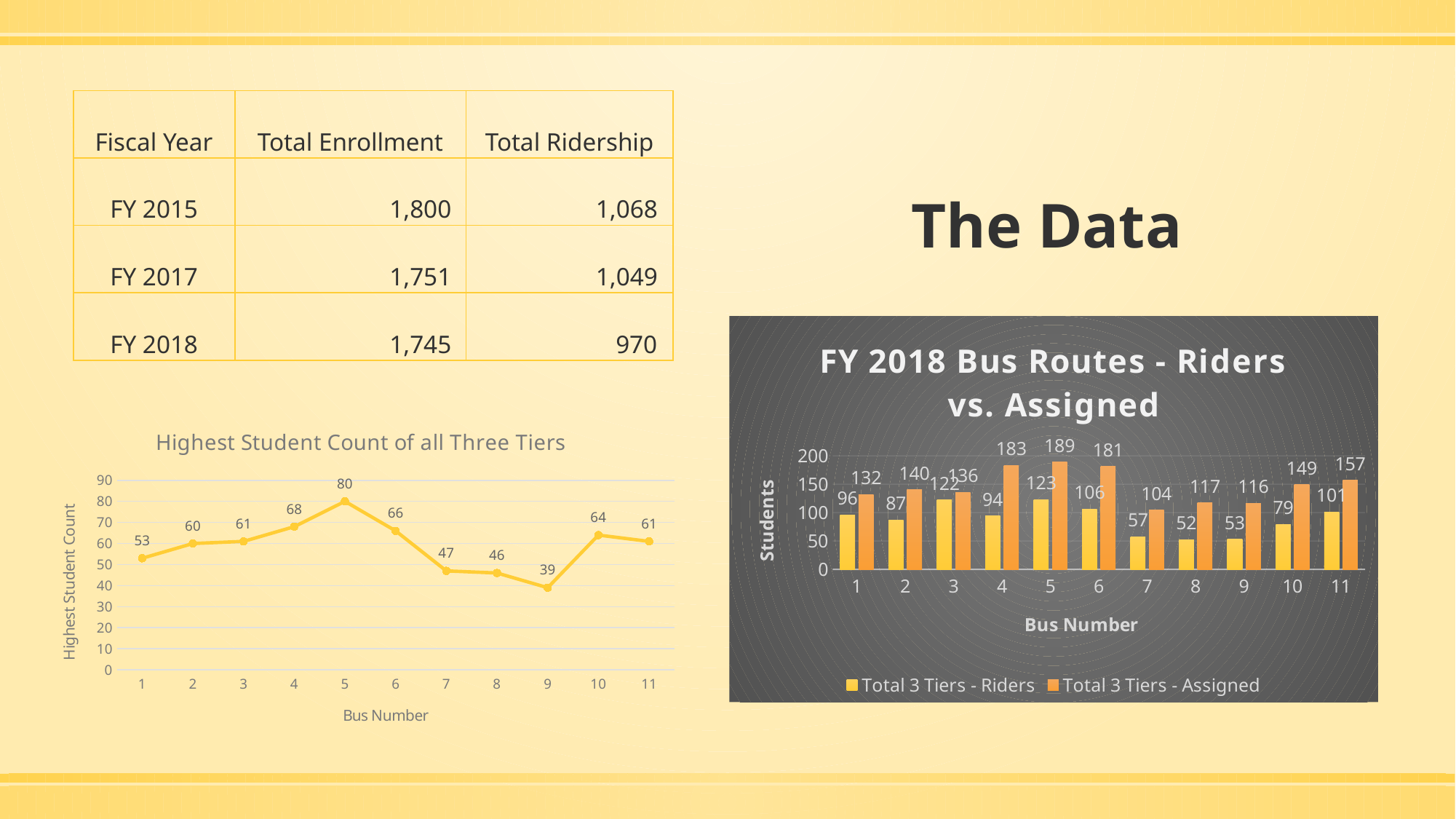
In the 'FY 2018 Bus Routes - Riders vs. Assigned' chart, what is the 'Total 3 Tiers - Assigned' value for bus 11? 157 What kind of chart is 'FY 2018 Bus Routes - Riders vs. Assigned'? bar chart How many bus numbers are plotted in the 'Highest Student Count of all Three Tiers' chart? 11 In the 'Highest Student Count of all Three Tiers' chart, what is the difference between the values for bus 5 and bus 9? 41 What kind of chart is 'Highest Student Count of all Three Tiers'? line chart In the 'Highest Student Count of all Three Tiers' chart, what is the value for bus number 5? 80 In the 'FY 2018 Bus Routes - Riders vs. Assigned' chart, which bus has the highest 'Total 3 Tiers - Assigned' value? 5 In the 'FY 2018 Bus Routes - Riders vs. Assigned' chart, which is larger for bus 8: the Riders value or the Assigned value? Assigned In the 'FY 2018 Bus Routes - Riders vs. Assigned' chart, what is the 'Total 3 Tiers - Riders' value for bus 4? 94 In the 'Highest Student Count of all Three Tiers' chart, which bus number has the lowest value? 9 How many series does the legend of the 'FY 2018 Bus Routes - Riders vs. Assigned' chart list? 2 In the 'FY 2018 Bus Routes - Riders vs. Assigned' chart, what is the difference between the Assigned and Riders values for bus 6? 75